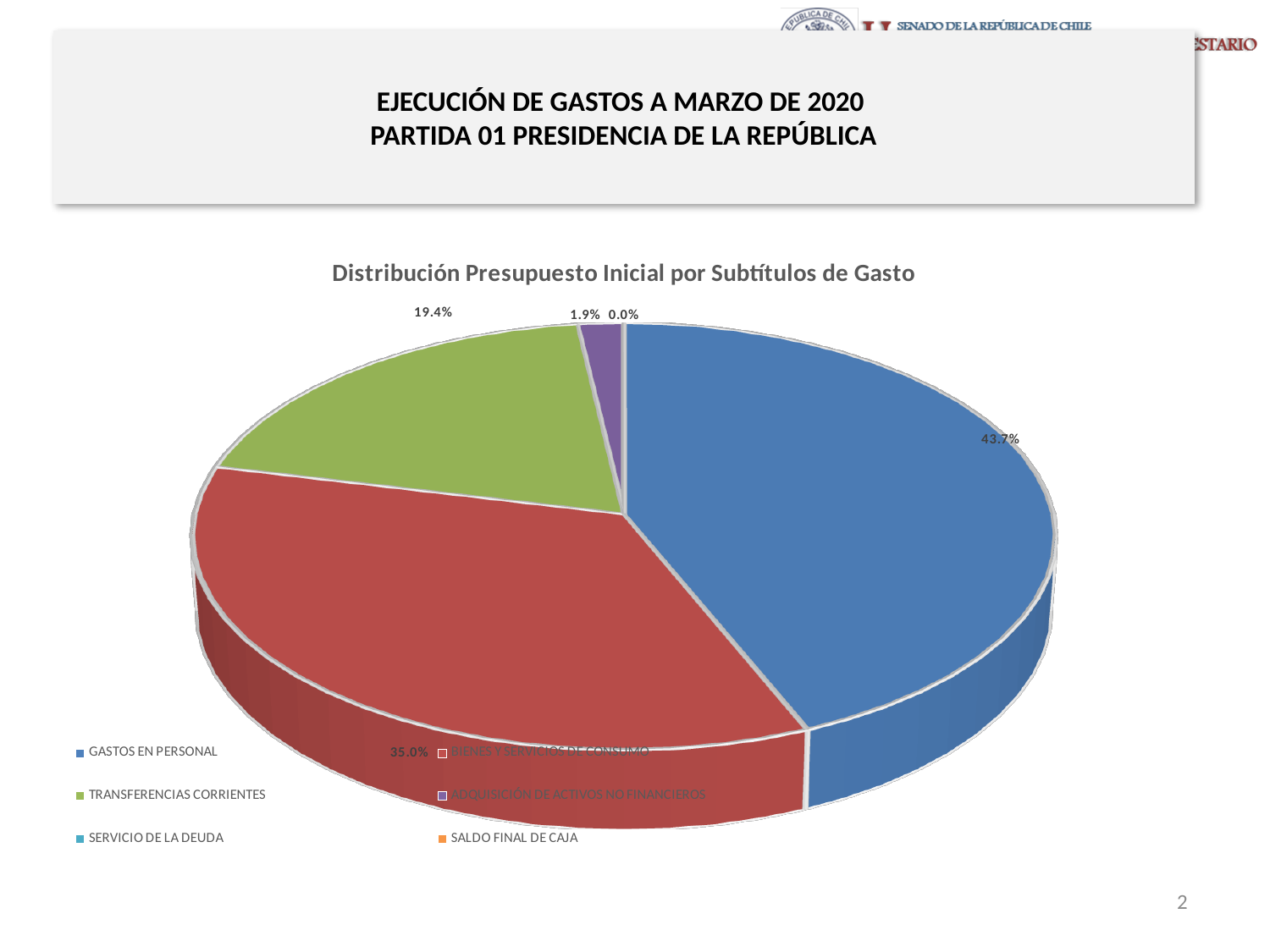
How many categories does the legend list? 6 What share of the pie does ADQUISICIÓN DE ACTIVOS NO FINANCIEROS represent? 1.9% Which is larger, the share for BIENES Y SERVICIOS DE CONSUMO or the share for TRANSFERENCIAS CORRIENTES? BIENES Y SERVICIOS DE CONSUMO What share of the pie does BIENES Y SERVICIOS DE CONSUMO represent? 35.0% What share of the pie does GASTOS EN PERSONAL represent? 43.7% Which category has the largest share of the pie? GASTOS EN PERSONAL What is the difference in percentage points between the GASTOS EN PERSONAL share and the BIENES Y SERVICIOS DE CONSUMO share? 8.7 What kind of chart is shown on the slide? pie chart What is the title of the chart? Distribución Presupuesto Inicial por Subtítulos de Gasto What colour is the slice for TRANSFERENCIAS CORRIENTES? green What is the difference in percentage points between the TRANSFERENCIAS CORRIENTES share and the ADQUISICIÓN DE ACTIVOS NO FINANCIEROS share? 17.5